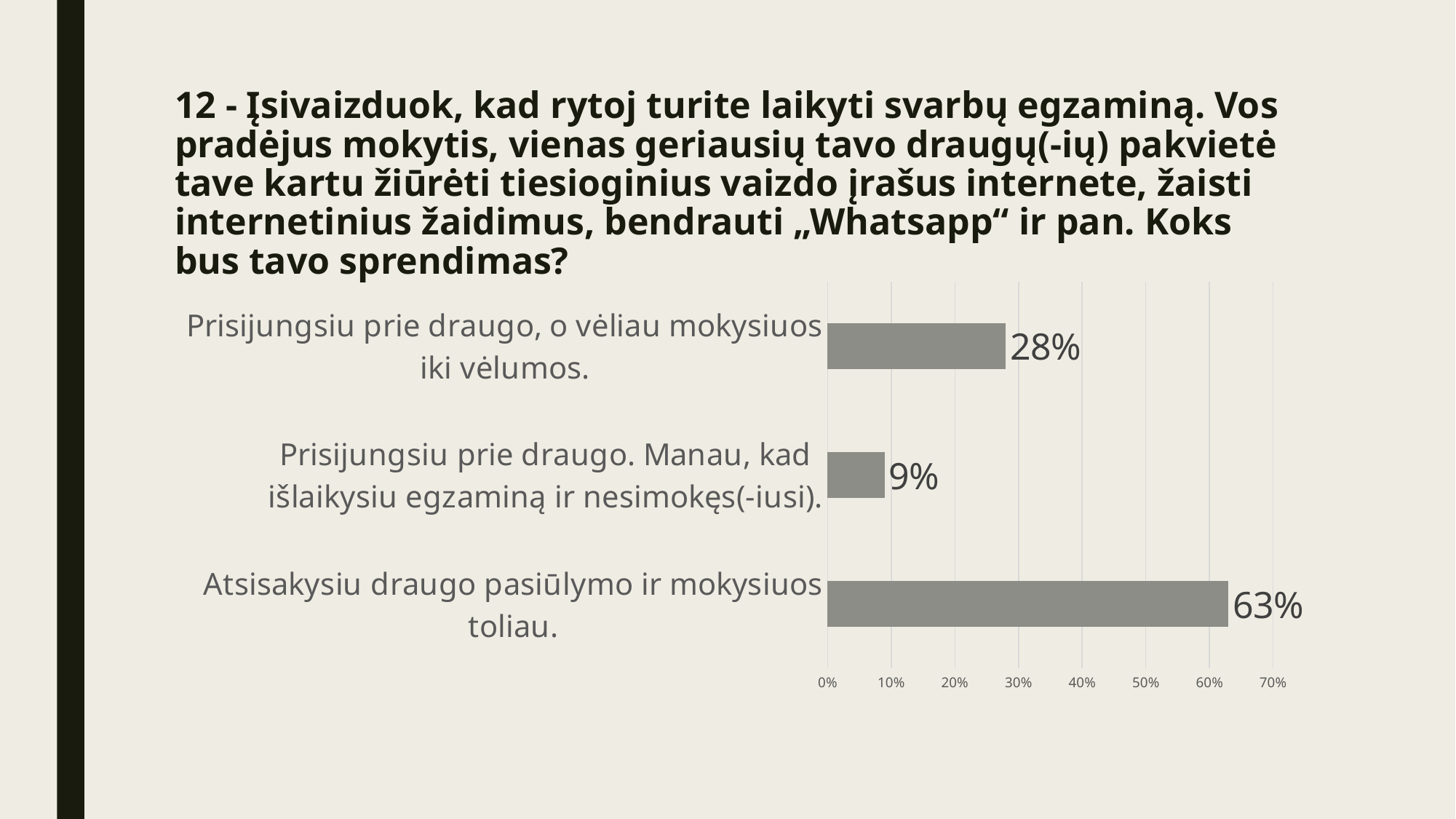
What percentage of respondents chose "Prisijungsiu prie draugo, o vėliau mokysiuos iki vėlumos."? 28% How many answer options are shown in the chart? 3 What percentage of respondents chose "Atsisakysiu draugo pasiūlymo ir mokysiuos toliau."? 63% Which answer option has the highest percentage? Atsisakysiu draugo pasiūlymo ir mokysiuos toliau. What is the difference in percentage points between "Prisijungsiu prie draugo, o vėliau mokysiuos iki vėlumos." and "Prisijungsiu prie draugo. Manau, kad išlaikysiu egzaminą ir nesimokęs(-iusi)."? 19 percentage points What kind of chart is shown on the slide? Bar chart What is the difference in percentage points between "Atsisakysiu draugo pasiūlymo ir mokysiuos toliau." and "Prisijungsiu prie draugo, o vėliau mokysiuos iki vėlumos."? 35 percentage points Which is larger: the value for "Prisijungsiu prie draugo, o vėliau mokysiuos iki vėlumos." or for "Prisijungsiu prie draugo. Manau, kad išlaikysiu egzaminą ir nesimokęs(-iusi)."? Prisijungsiu prie draugo, o vėliau mokysiuos iki vėlumos. What is the highest value shown on the x axis of the chart? 70% Which answer option has the lowest percentage? Prisijungsiu prie draugo. Manau, kad išlaikysiu egzaminą ir nesimokęs(-iusi). Is the value for "Atsisakysiu draugo pasiūlymo ir mokysiuos toliau." greater or less than 50%? greater What percentage of respondents chose "Prisijungsiu prie draugo. Manau, kad išlaikysiu egzaminą ir nesimokęs(-iusi)."? 9%